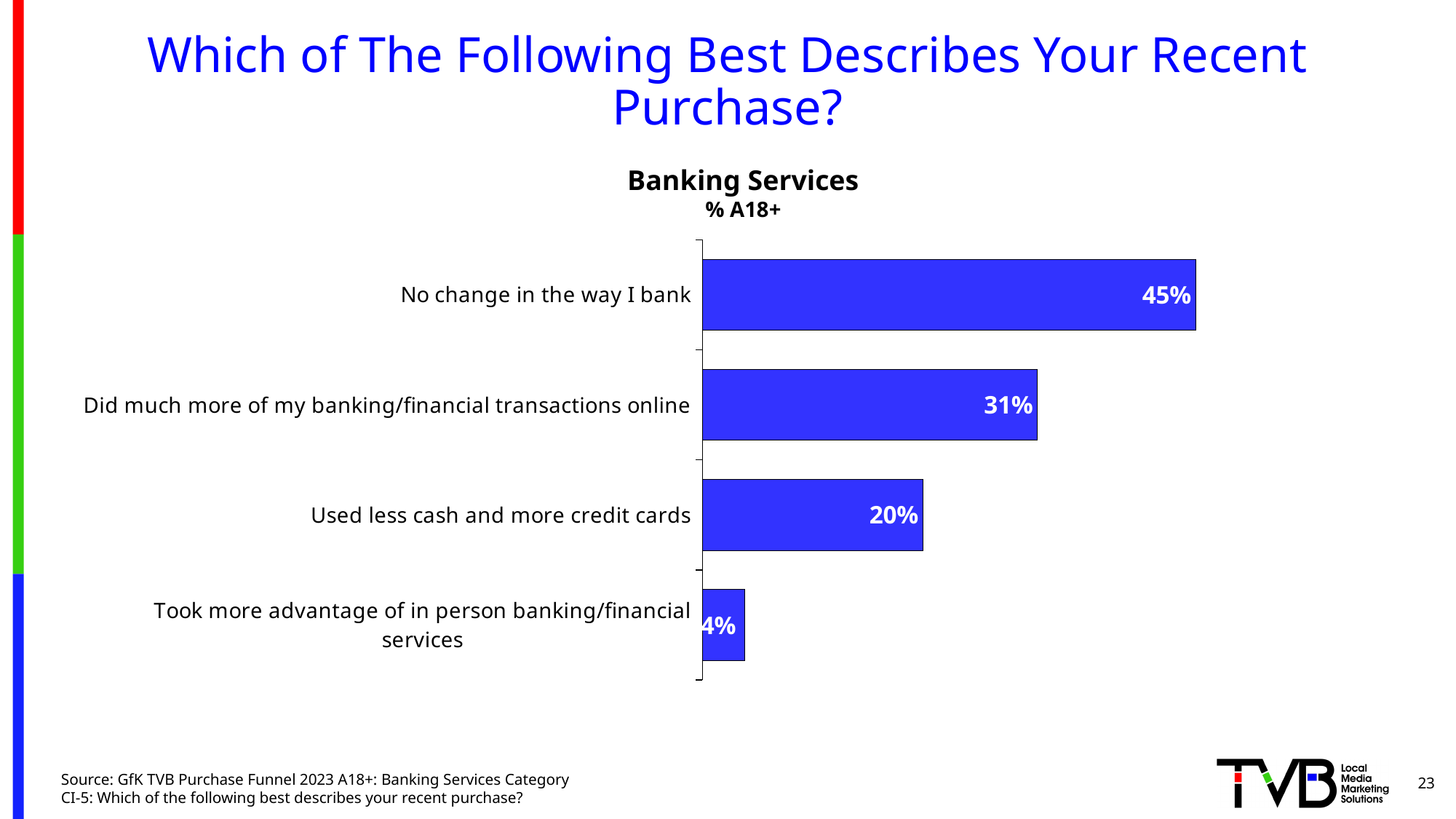
What is the title of the chart? Banking Services What percentage of A18+ said they used less cash and more credit cards? 20% What percentage of A18+ said they took more advantage of in person banking/financial services? 4% Which is larger: the percentage for 'Used less cash and more credit cards' or for 'Did much more of my banking/financial transactions online'? Did much more of my banking/financial transactions online Which response has the highest percentage? No change in the way I bank What percentage of A18+ said they did much more of their banking/financial transactions online? 31% How many response categories are shown in the chart? 4 What type of chart is shown on the slide? Bar chart Which response has the lowest percentage? Took more advantage of in person banking/financial services What is the difference in percentage points between 'No change in the way I bank' and 'Did much more of my banking/financial transactions online'? 14 What is the difference in percentage points between 'Used less cash and more credit cards' and 'Took more advantage of in person banking/financial services'? 16 What percentage of A18+ said 'No change in the way I bank'? 45%